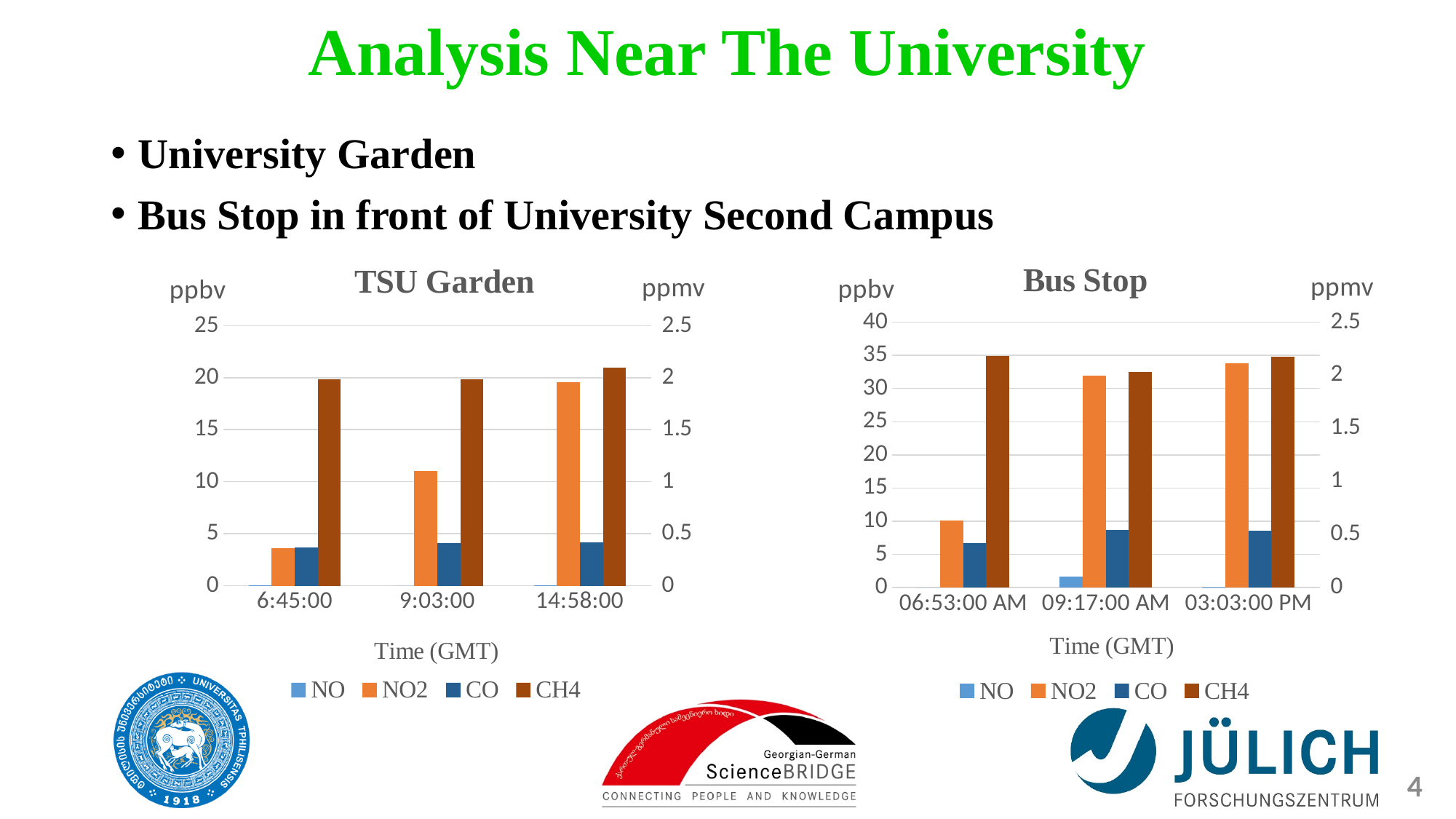
In the TSU Garden chart, does the NO2 value rise or fall from 6:45:00 to 14:58:00? rise In the Bus Stop chart, which time has the larger NO2 value, 06:53:00 AM or 09:17:00 AM? 09:17:00 AM How many series does the legend of the Bus Stop chart list? 4 What kind of chart is the TSU Garden chart? bar chart In the TSU Garden chart, at which time is NO2 highest? 14:58:00 In the Bus Stop chart, is the NO2 value at 09:17:00 AM greater or less than 30? greater What unit is shown on the right-hand axis of the Bus Stop chart? ppmv In the TSU Garden chart, which time has the larger NO2 value, 6:45:00 or 14:58:00? 14:58:00 How many time points are shown on the x axis of the TSU Garden chart? 3 In the Bus Stop chart, is the NO2 value at 06:53:00 AM greater or less than 15? less In the Bus Stop chart, at which time is NO2 lowest? 06:53:00 AM In the TSU Garden chart, is the NO2 value at 9:03:00 greater or less than 15? less